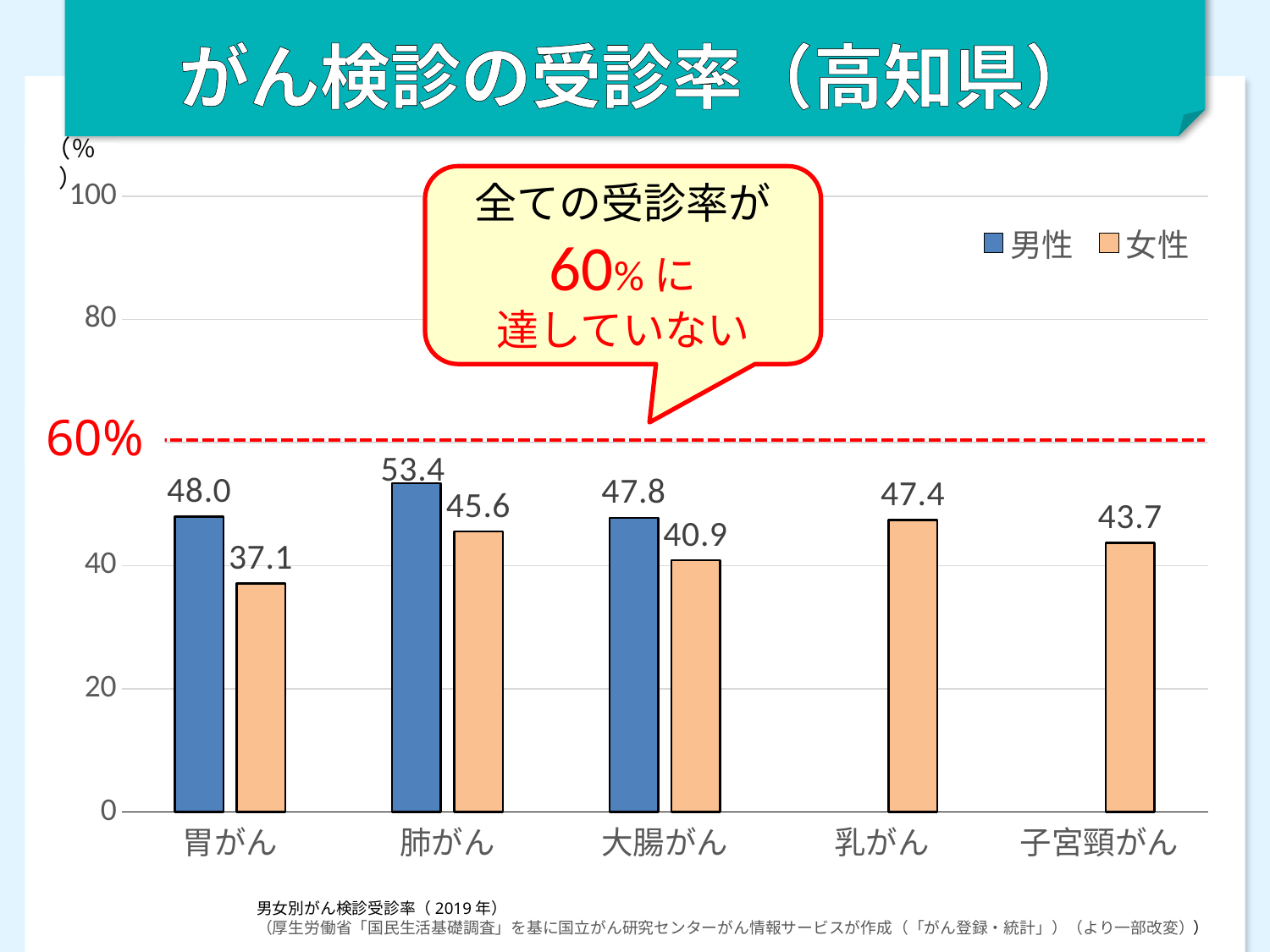
Which cancer type has the lowest 女性 (female) screening rate? 胃がん What is the screening rate for 女性 (female) for 子宮頸がん? 43.7 What is the screening rate for 女性 (female) for 肺がん? 45.6 Which cancer type has the highest 男性 (male) screening rate? 肺がん What kind of chart is shown on the slide? bar chart What value does the red dashed horizontal line mark? 60% How many cancer types are shown on the x axis? 5 Which is larger: the 女性 rate for 乳がん or the 女性 rate for 大腸がん? 乳がん What is the difference between the 男性 and 女性 screening rates for 胃がん? 10.9 What is the screening rate for 男性 (male) for 胃がん? 48.0 Is the 男性 screening rate for 肺がん greater or less than 60? less How many series does the legend list? 2